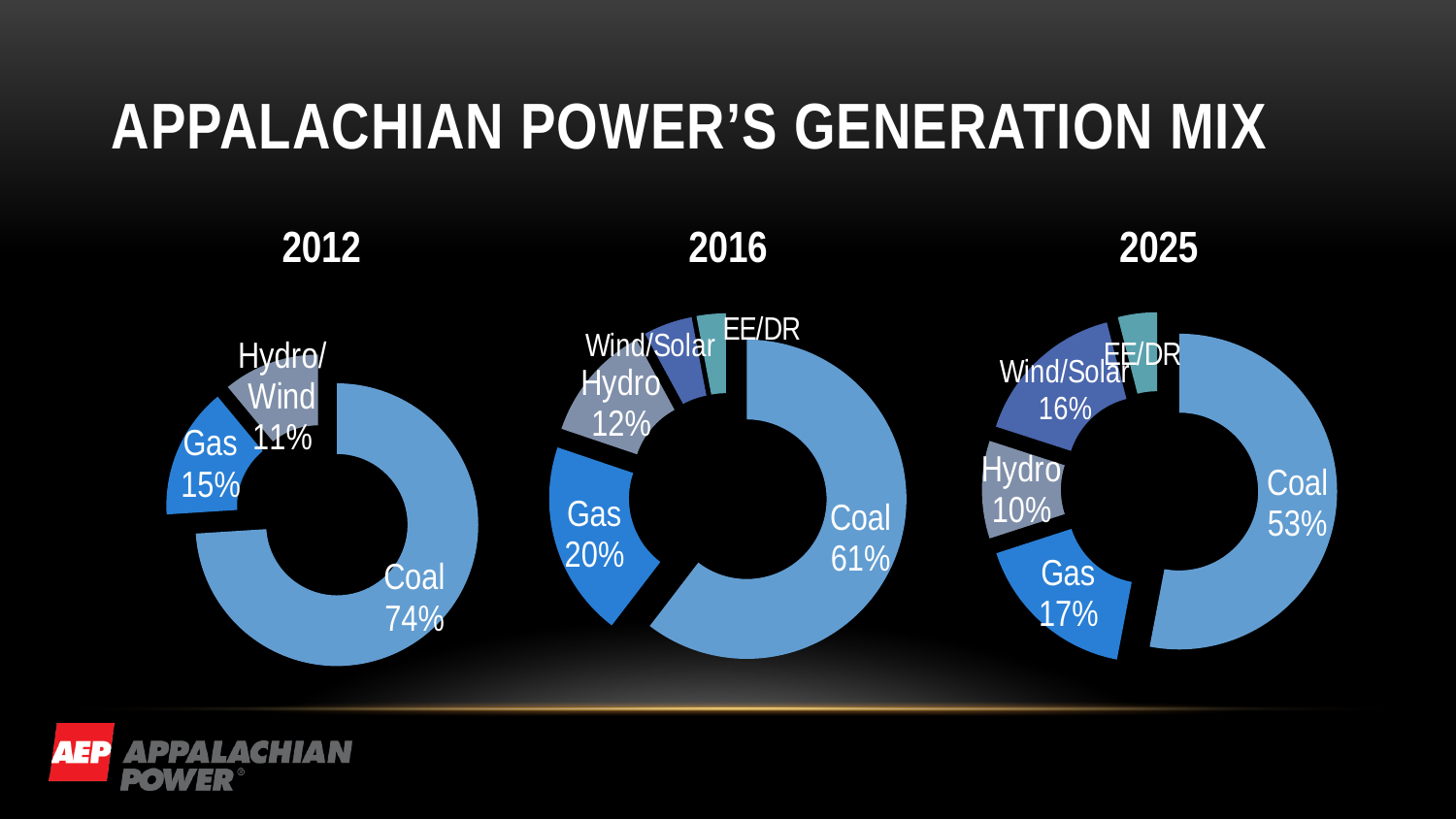
What kind of chart is used to show the 2016 generation mix? Doughnut chart In the 2012 chart, what share of the generation mix is Coal? 74% In the 2025 chart, what share of the generation mix is Wind/Solar? 16% In the 2012 chart, what share of the generation mix is Hydro/Wind? 11% In the 2025 chart, which is larger, the Gas share or the Hydro share? Gas In the 2016 chart, what share of the generation mix is Gas? 20% In the 2012 chart, what share of the generation mix is Gas? 15% In the 2025 chart, which category has the largest share? Coal In the 2016 chart, what share of the generation mix is Coal? 61% How many categories are shown in the 2025 chart? 5 What is the difference between the Coal share in the 2012 chart and the Coal share in the 2025 chart? 21% In the 2012 chart, which labelled category has the smallest share? Hydro/Wind